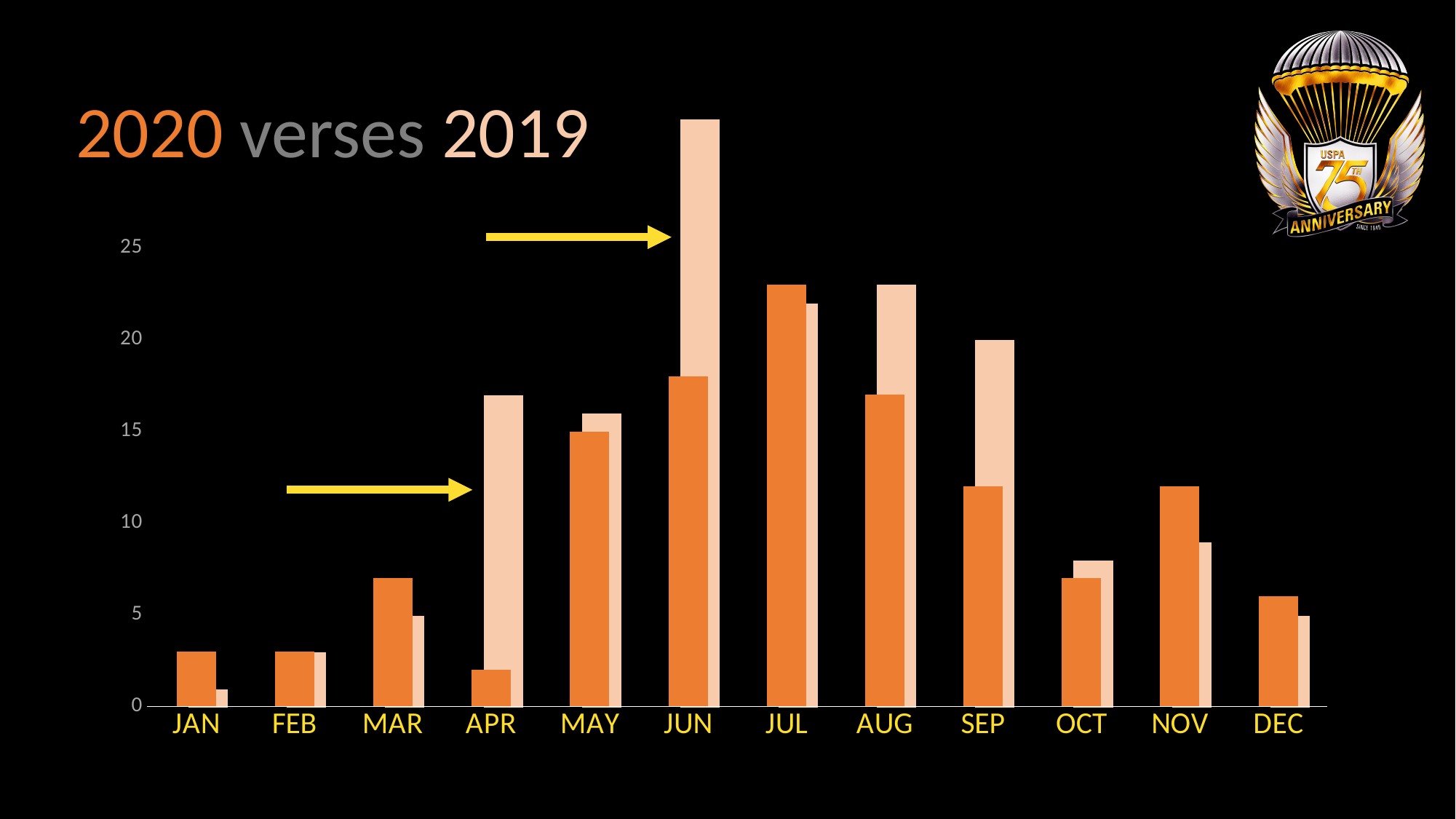
In which month is the 2020 (dark orange) bar the highest? JUL For NOV, which year has the larger value, 2020 or 2019? 2020 Is the 2020 value for APR greater or less than 5? less In which month is the 2020 (dark orange) bar the lowest? APR How many data series does the chart compare? 2 In which month is the 2019 (light peach) bar the highest? JUN What is the title of the chart on the slide? 2020 verses 2019 What kind of chart is shown on the slide? bar chart Is the 2019 value for JUN greater or less than 25? greater Is the 2020 value for JUL greater or less than 20? greater How many months are shown along the x axis of the chart? 12 For JUN, which year has the larger value, 2020 or 2019? 2019